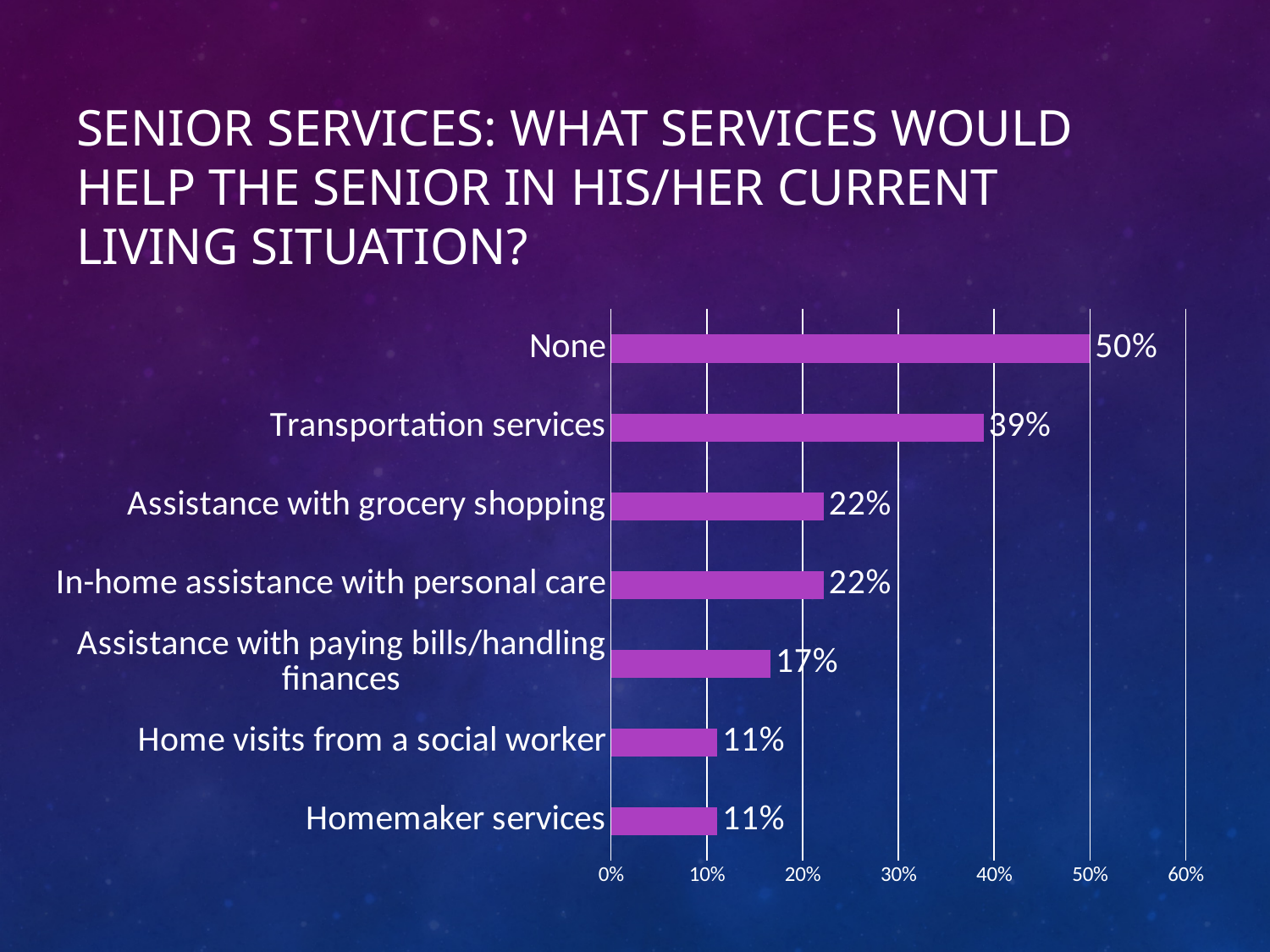
Is the value for Assistance with paying bills/handling finances greater or less than 20%? less What is the value for Assistance with paying bills/handling finances? 17% What kind of chart is shown on the slide? Bar chart How many categories are shown in the chart? 7 Which category has the highest value? None What is the difference between the values for Assistance with grocery shopping and Homemaker services? 11% Which is larger, the value for Transportation services or the value for In-home assistance with personal care? Transportation services What is the value for Home visits from a social worker? 11% What is the maximum value shown on the horizontal axis? 60% Is the value for None greater or less than 40%? greater What is the difference between the values for None and Transportation services? 11% What is the value for Transportation services? 39%